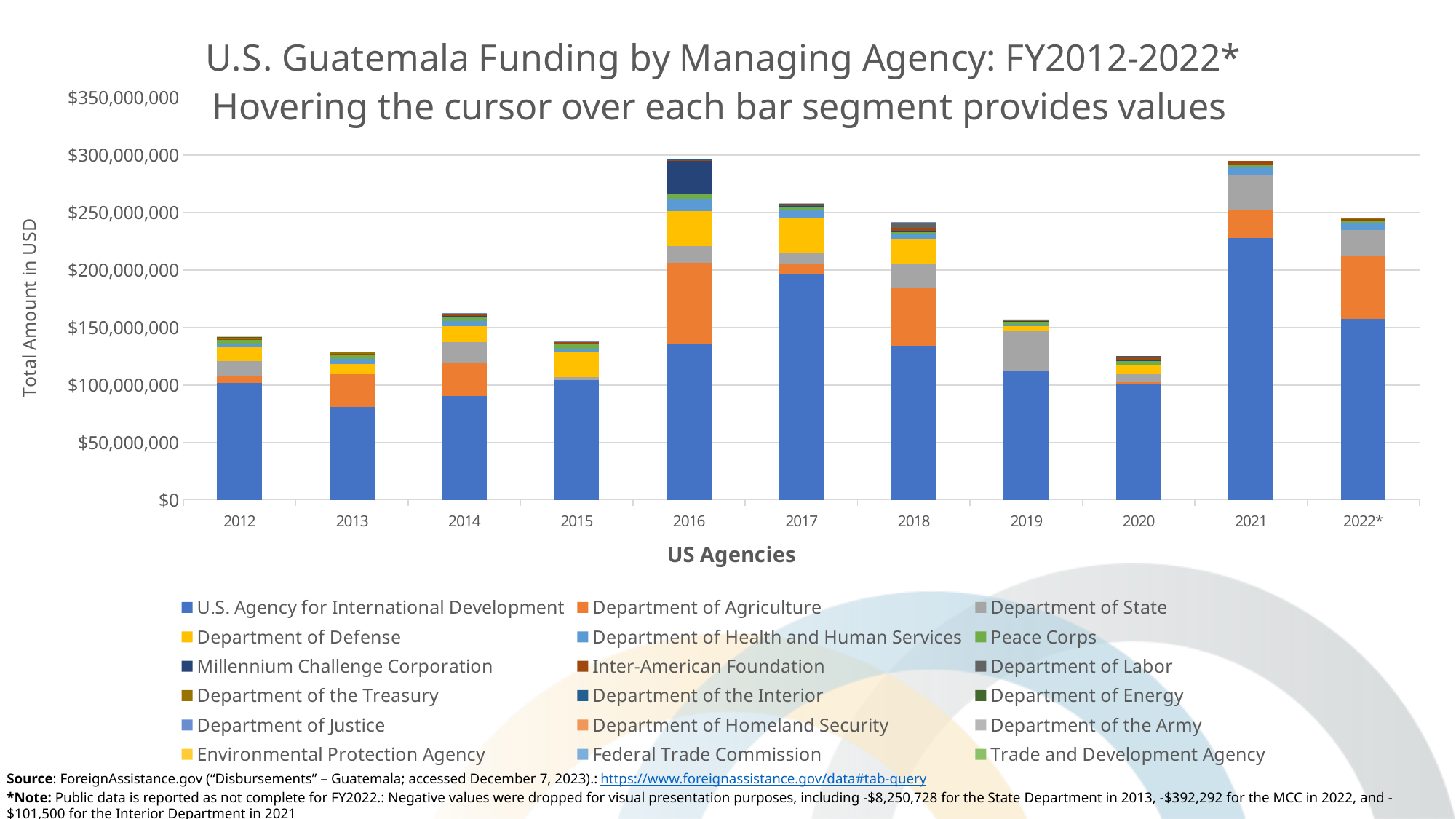
What is the label on the y axis? Total Amount in USD How many agencies does the legend list? 18 How many fiscal years (bars) are plotted on the x axis? 11 What is the title of the chart? U.S. Guatemala Funding by Managing Agency: FY2012-2022* Hovering the cursor over each bar segment provides values Do the total funding values rise or fall from 2017 to 2020? fall Is the total funding for 2016 greater or less than $250,000,000? greater What kind of chart is shown on the slide? Stacked bar chart Is the total funding for 2020 greater or less than $150,000,000? less Which year has the larger total funding, 2017 or 2018? 2017 Is the U.S. Agency for International Development segment for 2021 greater or less than $200,000,000? greater